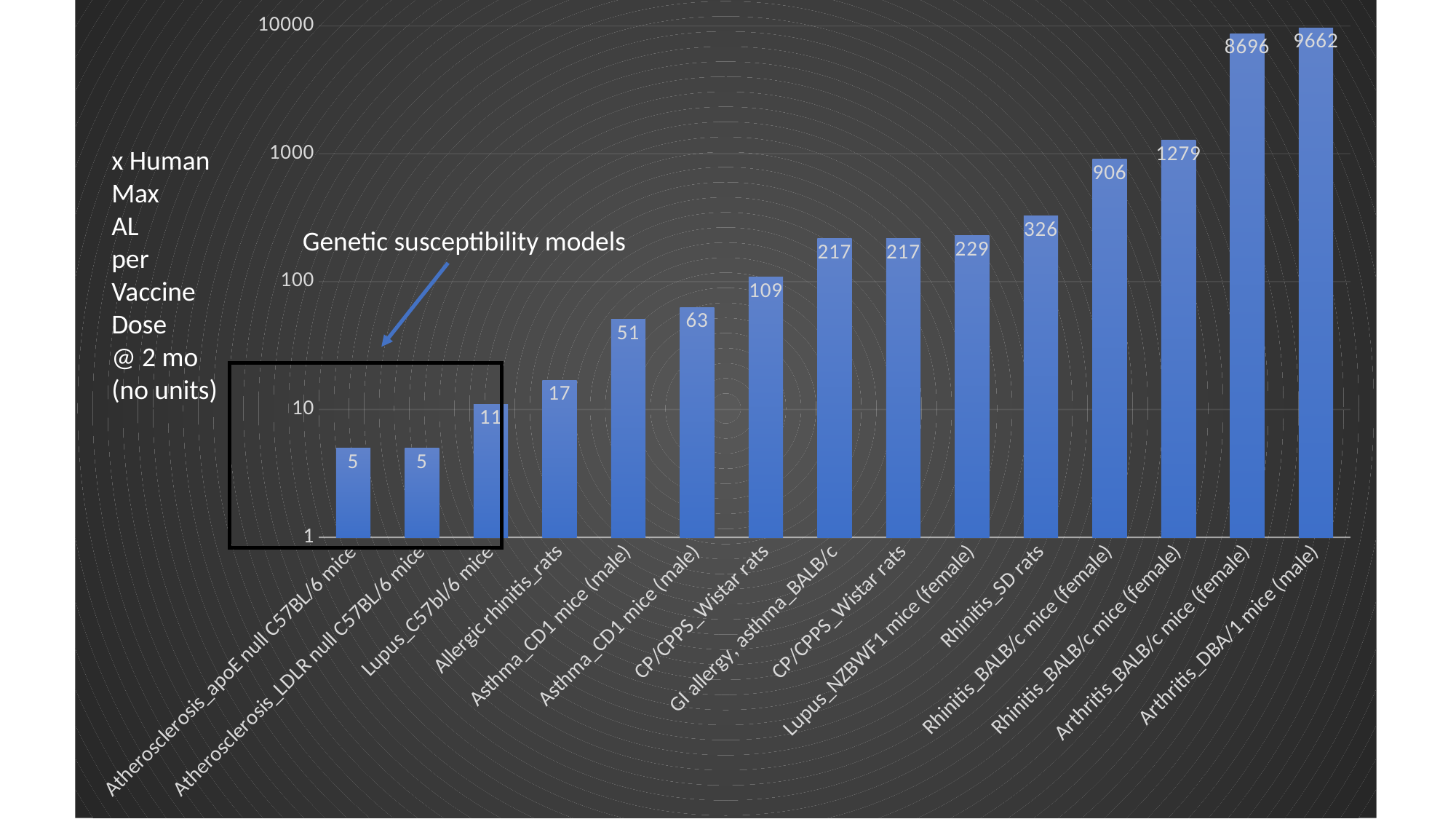
What label is given to the boxed group of the first three bars? Genetic susceptibility models What is the difference between the values for Rhinitis_BALB/c mice (female) with value 1279 and Rhinitis_BALB/c mice (female) with value 906? 373 Which category has the highest value? Arthritis_DBA/1 mice (male) Is the value for Lupus_NZBWF1 mice (female) greater or less than 100? greater What is the value for CP/CPPS_Wistar rats (the first of the two CP/CPPS_Wistar rats bars)? 109 What is the difference between the values for Arthritis_DBA/1 mice (male) and Arthritis_BALB/c mice (female)? 966 What is the value for Lupus_C57bl/6 mice? 11 How many bars are plotted in the chart? 15 What is the value for Rhinitis_SD rats? 326 What is the value for Arthritis_DBA/1 mice (male)? 9662 What kind of chart is shown on the slide? bar chart Which is larger, the value for Asthma_CD1 mice (male) at 63 or the value for Allergic rhinitis_rats? Asthma_CD1 mice (male)